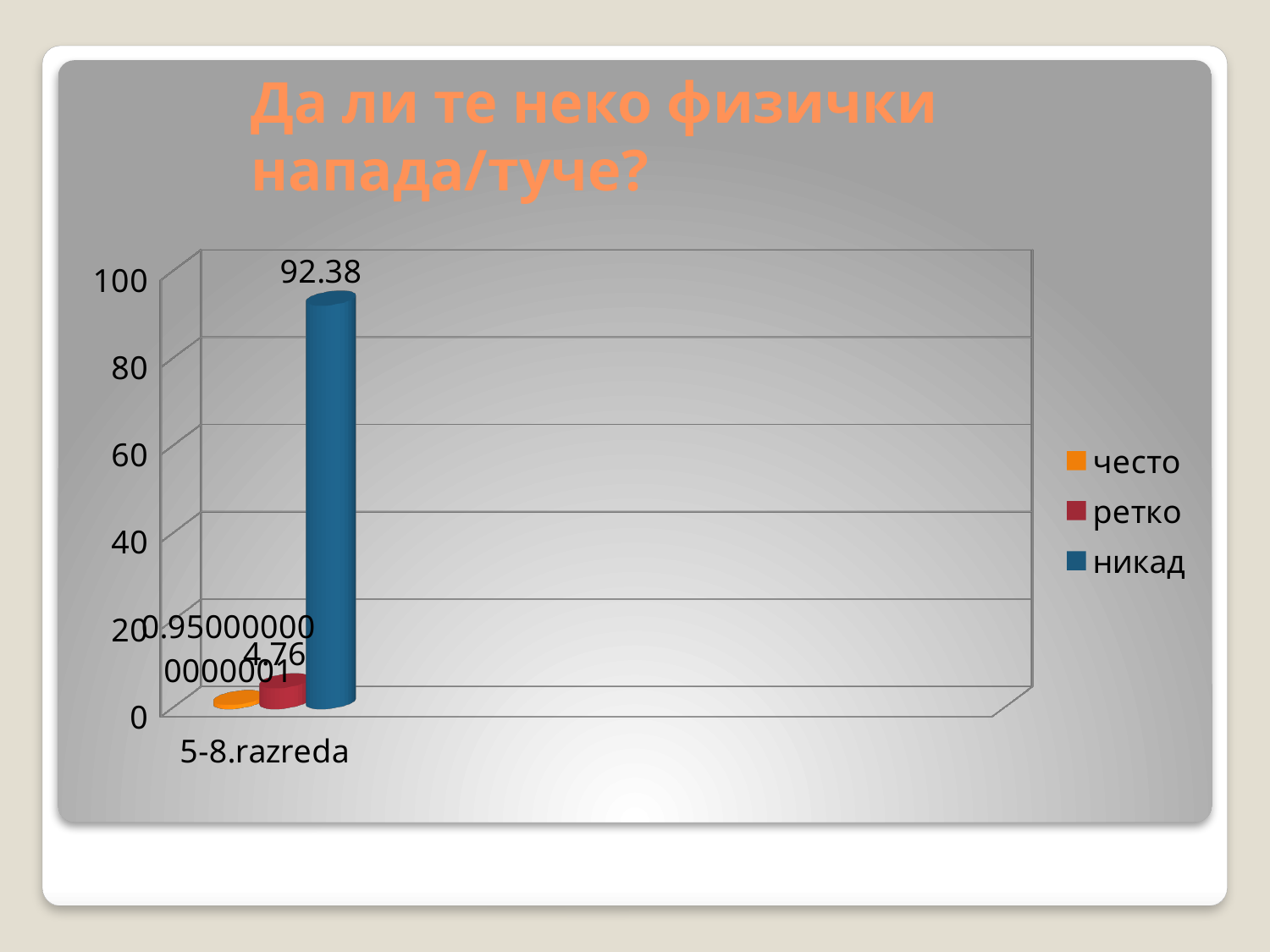
What kind of chart is shown on the slide? bar chart Which is larger, the value for ретко or the value for никад? никад How many categories are shown on the x axis? 1 What is the value for никад for 5-8.razreda? 92.38 Which series has the highest value for 5-8.razreda? никад What is the value for ретко for 5-8.razreda? 4.76 How many series does the legend list? 3 What is the difference between the values for никад and ретко? 87.62 Is the value for никад greater or less than 80? greater Which series has the lowest value for 5-8.razreda? често What colour is the bar for никад? blue Is the value for често greater or less than 20? less